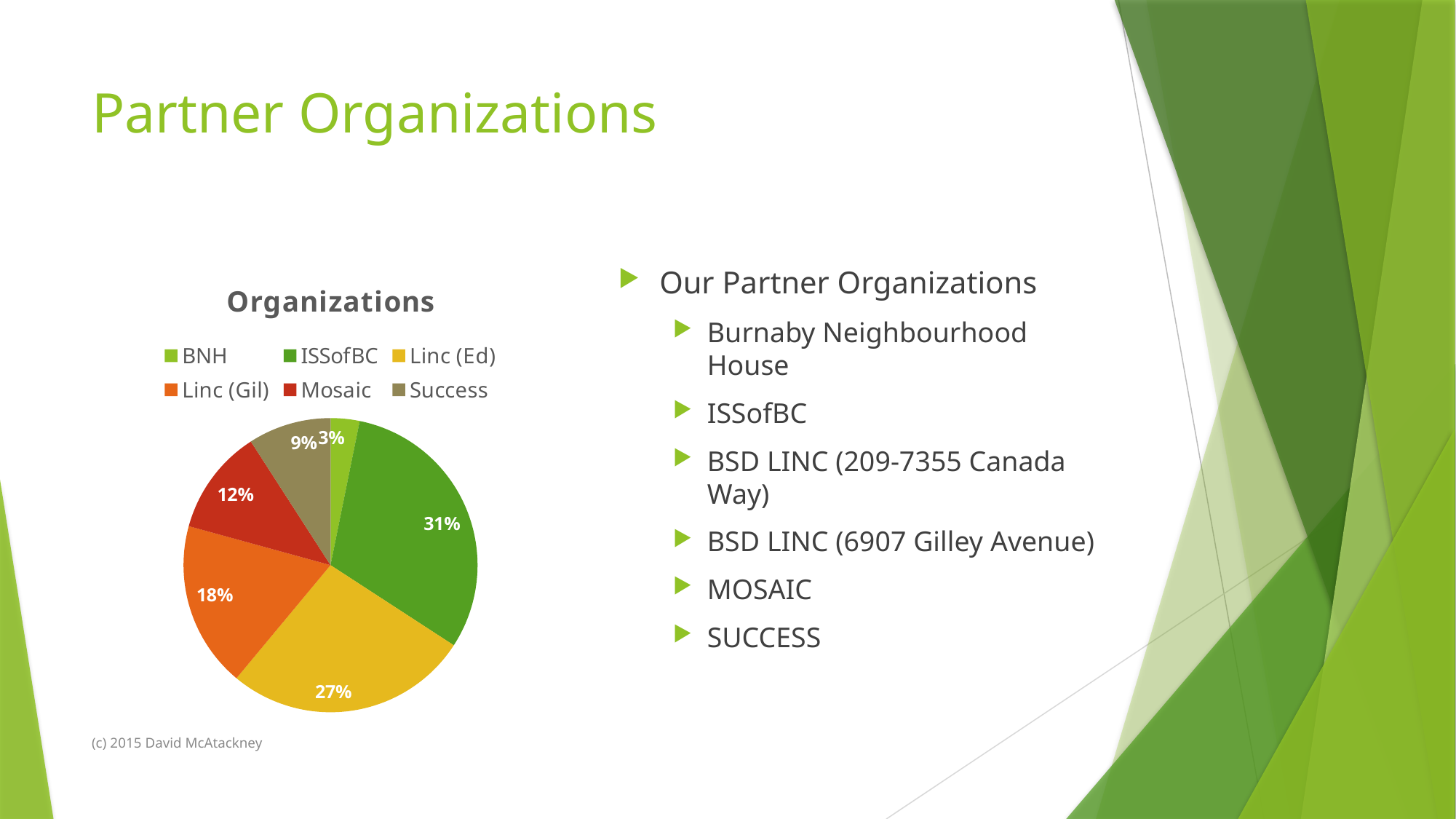
What type of chart is shown on the slide? pie chart Which organization has the largest slice of the pie? ISSofBC What share of the pie does Mosaic have? 12% What is the difference in percentage points between ISSofBC and Linc (Ed)? 4 What share of the pie does Success have? 9% What share of the pie does Linc (Gil) have? 18% How many organizations are listed in the chart legend? 6 Which has a larger share, Linc (Gil) or Mosaic? Linc (Gil) What is the title of the chart? Organizations What share of the pie does ISSofBC have? 31% What share of the pie does Linc (Ed) have? 27% Which organization has the smallest slice of the pie? BNH